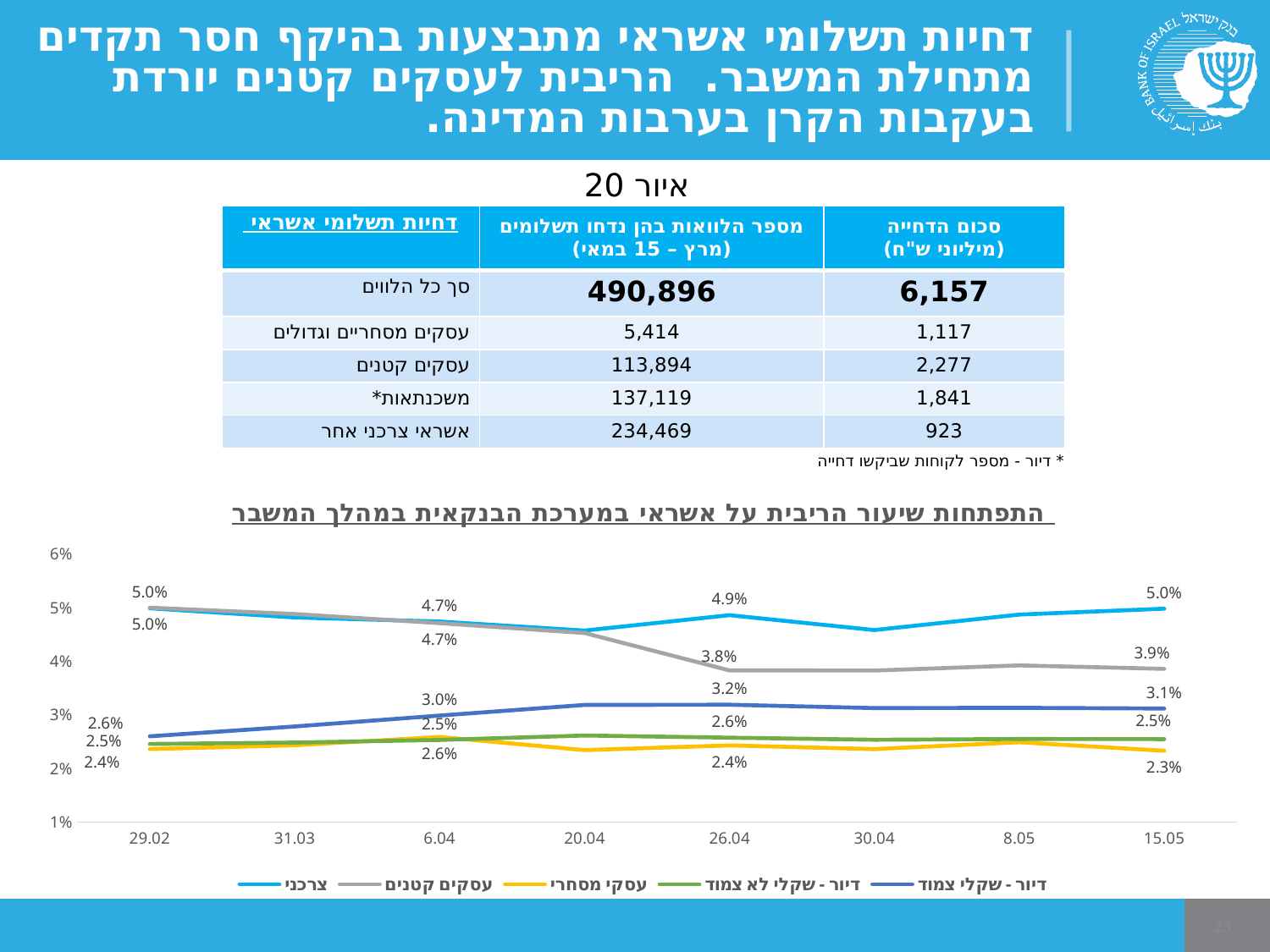
In the line chart, which series has the lowest value at 15.05? עסקי מסחרי How many series does the legend of the line chart list? 5 In the line chart, what is the value of the צרכני series at 15.05? 5.0% In the line chart, what is the value of the עסקים קטנים series at 26.04? 3.8% What kind of chart is shown at the bottom of the slide? line chart In the line chart, is the value of the צרכני series at 30.04 greater or less than 4%? greater How many dates are shown on the x axis of the line chart? 8 In the line chart, does the עסקים קטנים series rise or fall from 29.02 to 15.05? fall In the line chart, what is the value of the צרכני series at 26.04? 4.9% In the line chart, what is the difference between the צרכני value and the עסקים קטנים value at 15.05? 1.1% In the line chart, which series has the highest value at 15.05? צרכני In the line chart, what is the value of the עסקים קטנים series at 15.05? 3.9%